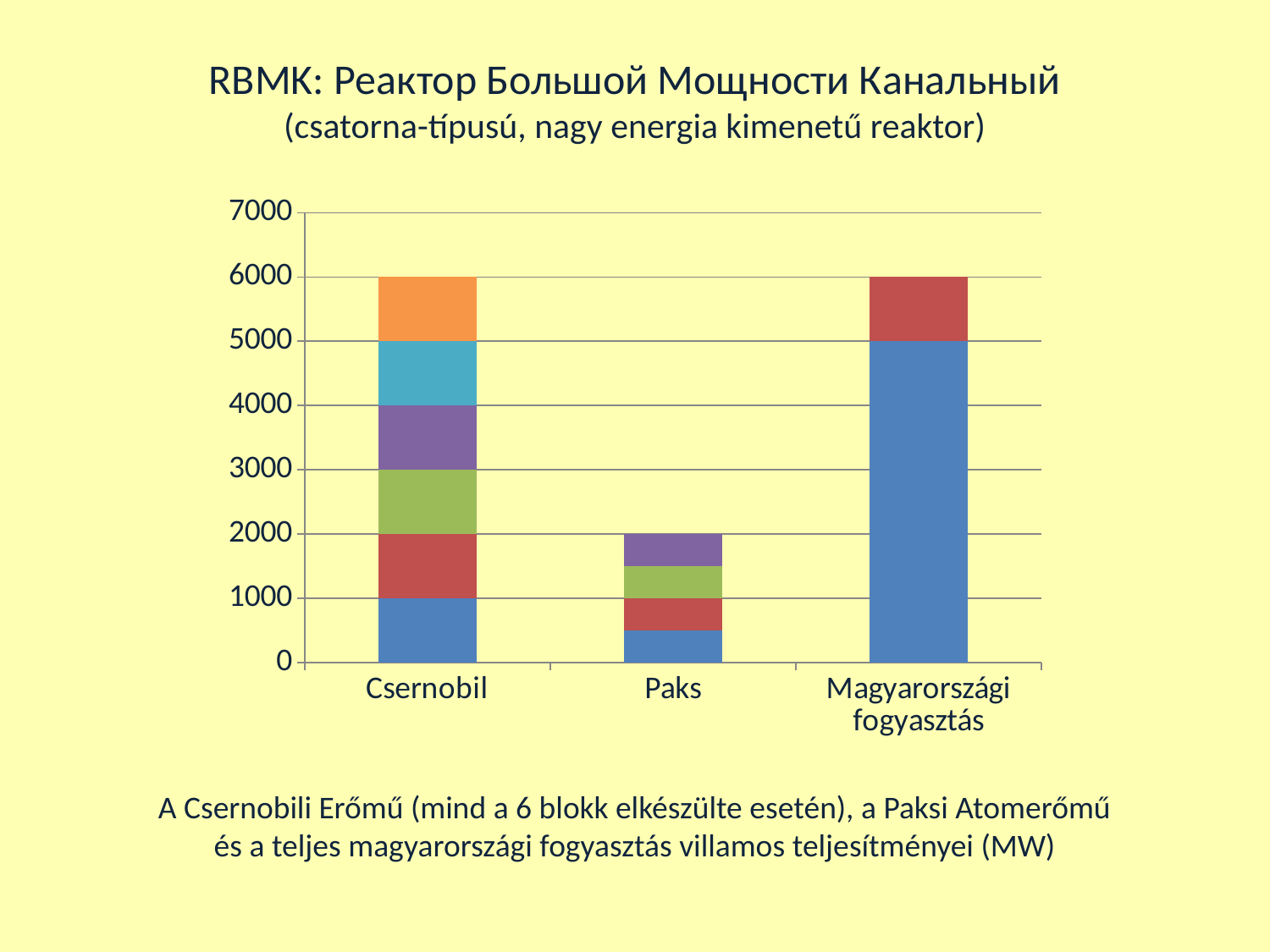
Which category has the lowest total value? Paks What is the total height of the Paks bar? 2000 What is the total height of the Csernobil bar? 6000 Which is larger, the total for Csernobil or the total for Paks? Csernobil What is the value of the bottom (blue) segment of the Csernobil bar? 1000 What is the value of the bottom (blue) segment of the Magyarországi fogyasztás bar? 5000 What is the difference between the total for Csernobil and the total for Paks? 4000 Is the total value for Paks greater or less than 3000? less How many stacked segments make up the Csernobil bar? 6 What is the total height of the Magyarországi fogyasztás bar? 6000 How many categories are shown on the x axis of the chart? 3 What kind of chart is shown on the slide? Stacked bar chart